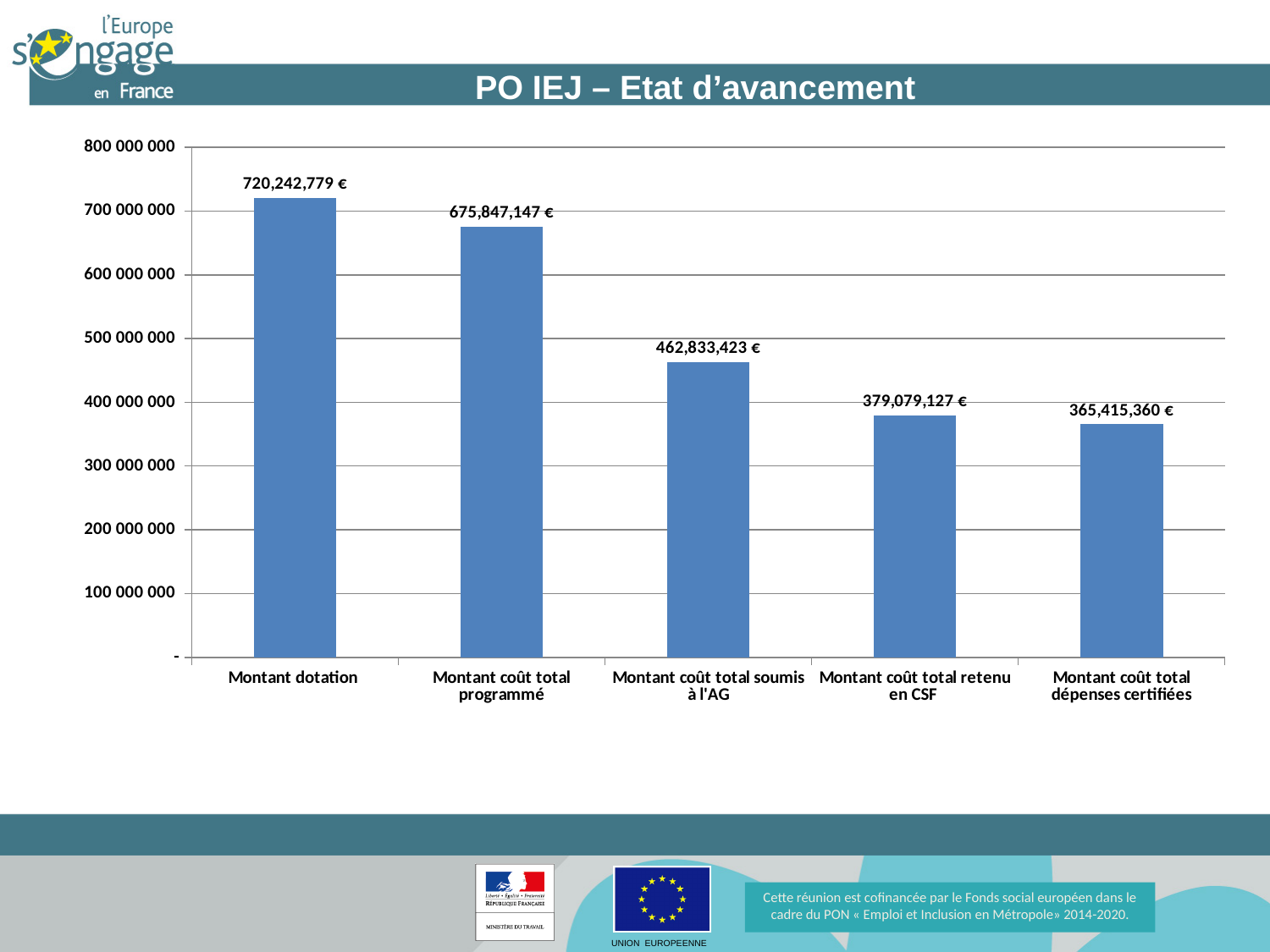
What is the value for Montant dotation? 720,242,779 € What is the value for Montant coût total programmé? 675,847,147 € Do the values rise or fall from left to right along the x axis? Fall What kind of chart is shown on the slide? Bar chart What is the value for Montant coût total soumis à l'AG? 462,833,423 € Which category has the lowest value? Montant coût total dépenses certifiées Which is larger, Montant coût total soumis à l'AG or Montant coût total retenu en CSF? Montant coût total soumis à l'AG What is the value for Montant coût total dépenses certifiées? 365,415,360 € What is the difference between Montant coût total retenu en CSF and Montant coût total dépenses certifiées? 13,663,767 € How many categories are shown in the chart? 5 Which category has the highest value? Montant dotation What is the difference between Montant dotation and Montant coût total programmé? 44,395,632 €